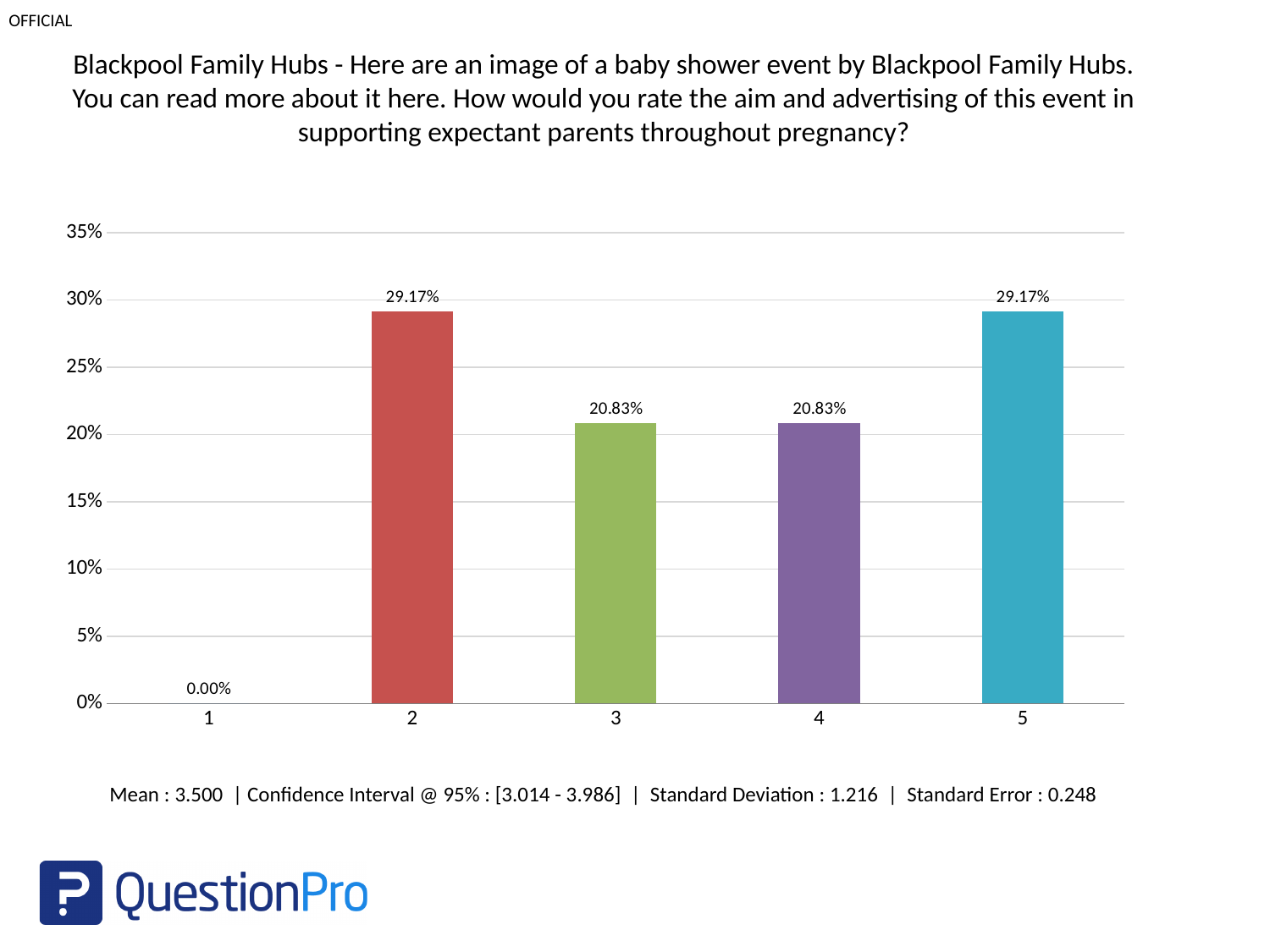
What is the value for rating 5? 29.17% What is the difference between the values for rating 2 and rating 3? 8.34% What colour is the bar for rating 2? red What is the mean value reported below the chart? 3.500 Is the value for rating 3 greater or less than 25%? less How many rating categories are shown on the x axis? 5 Which is larger, the value for rating 4 or the value for rating 5? rating 5 Which rating category has the lowest value? 1 What is the value for rating 3? 20.83% What is the value for rating 2? 29.17% What is the value for rating 1? 0.00% What kind of chart is shown on the slide? bar chart